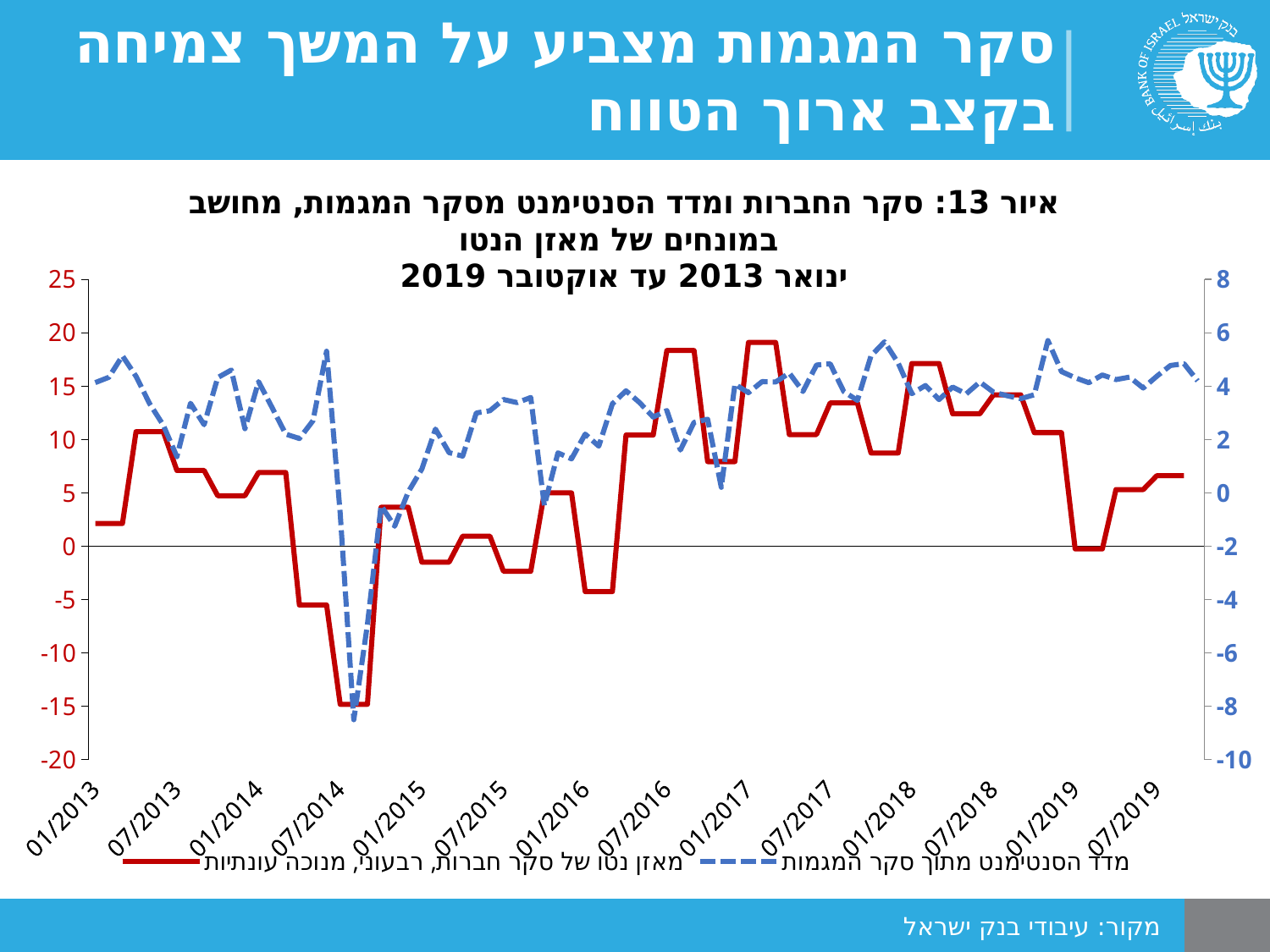
Which series is drawn as a dashed blue line? מדד הסנטימנט מתוך סקר המגמות Does the red solid line rise or fall between 01/2013 and 07/2013? rise How many date labels are shown on the x axis? 14 Is the lowest value of the blue dashed line (מדד הסנטימנט), reached in late 2014, greater or less than -6 on the right axis? less What kind of chart is shown on the slide? line chart How many series does the legend list? 2 What is the figure number given in the chart title? איור 13 Is the lowest value of the red solid line (מאזן נטו של סקר חברות) greater or less than -10 on the left axis? less Is the highest value of the red solid line (מאזן נטו של סקר חברות), reached around 01/2017, greater or less than 15 on the left axis? greater What is the maximum value shown on the right-hand y axis? 8